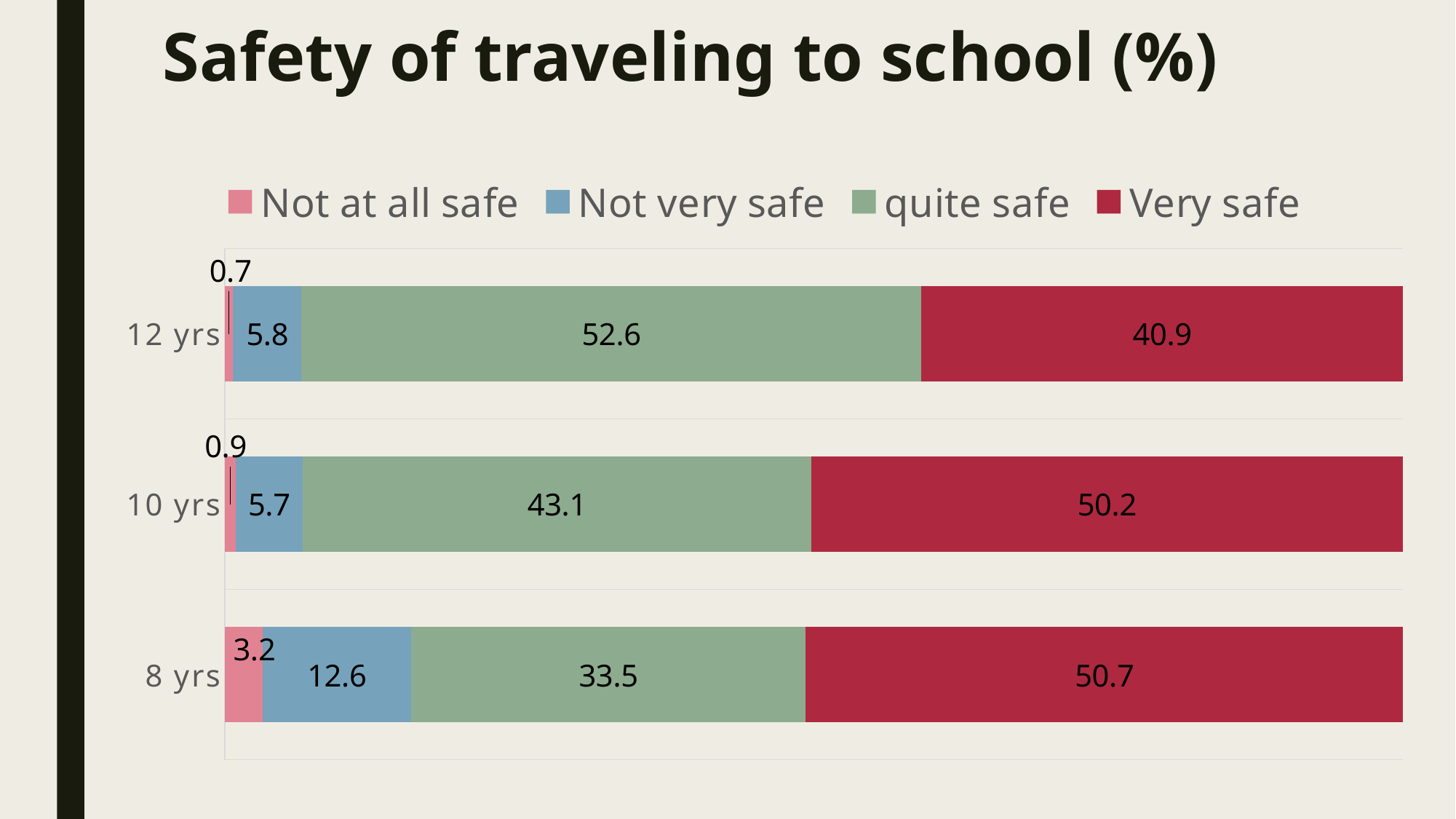
What is the title of the chart? Safety of traveling to school (%) Which is larger: 'Not very safe' for 8 yrs or 'Not very safe' for 10 yrs? 8 yrs How many age groups are shown on the chart? 3 What kind of chart is shown on the slide? Stacked bar chart Which age group has the lowest value for 'Very safe'? 12 yrs What is the value for 'Not very safe' for 8 yrs? 12.6 How many series does the legend list? 4 What is the difference between the 'quite safe' values for 12 yrs and 8 yrs? 19.1 What is the value for 'Very safe' for 10 yrs? 50.2 What is the value for 'quite safe' for 12 yrs? 52.6 What is the value for 'Not at all safe' for 12 yrs? 0.7 Which age group has the highest value for 'quite safe'? 12 yrs